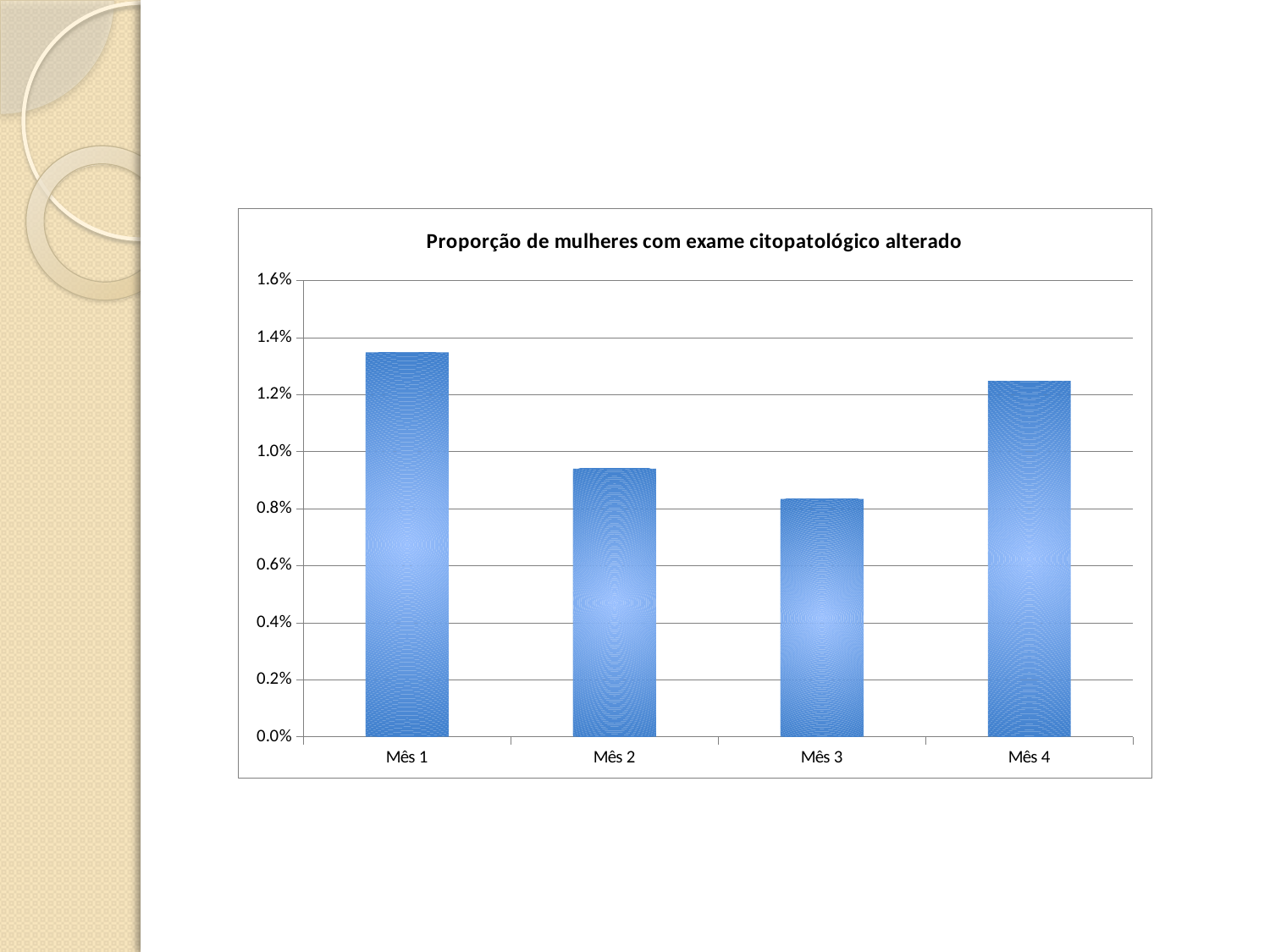
Which month has the highest proportion? Mês 1 What is the title of the chart? Proporção de mulheres com exame citopatológico alterado Which is larger, the value for Mês 1 or the value for Mês 4? Mês 1 What kind of chart is shown on the slide? Bar chart How many categories (months) are shown on the x axis? 4 Is the value for Mês 2 greater or less than 1.0%? less Is the value for Mês 3 greater or less than 1.0%? less Which month has the lowest proportion? Mês 3 Is the value for Mês 1 greater or less than 1.2%? greater Which is larger, the value for Mês 2 or the value for Mês 3? Mês 2 Do the values rise or fall from Mês 1 to Mês 3? fall